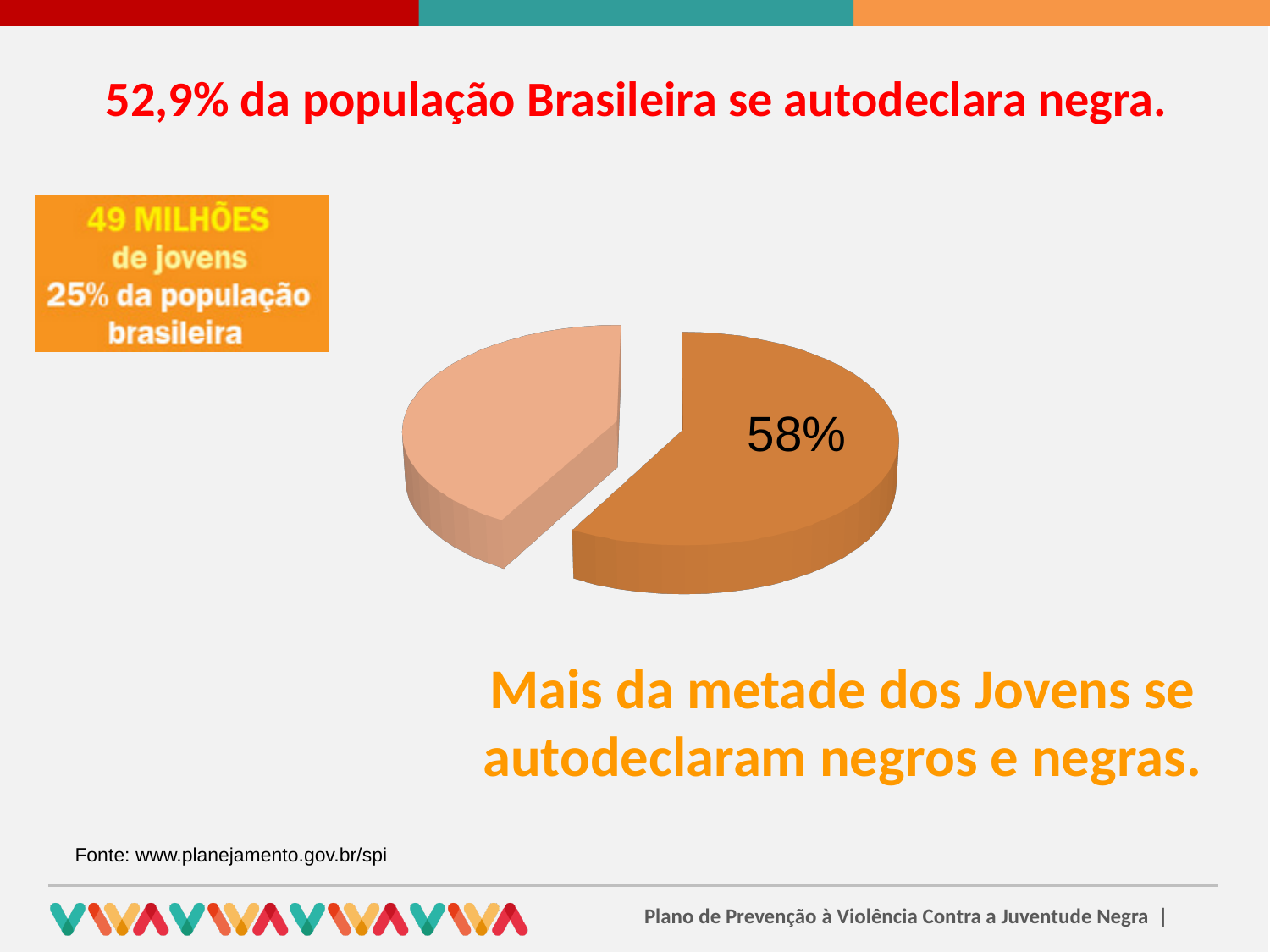
Which slice of the pie chart is the smallest? The lighter peach slice Which slice of the pie chart is larger, the darker orange slice or the lighter peach slice? The darker orange slice Is the value of the labelled slice in the pie chart greater or less than 50%? greater Is the pie chart drawn in 3D? Yes What kind of chart is shown on the slide? Pie chart What share of the pie does the unlabelled lighter slice represent? 42% How many slices does the pie chart have? 2 What percentage is printed on the labelled slice of the pie chart? 58% Does the pie chart include a legend? No